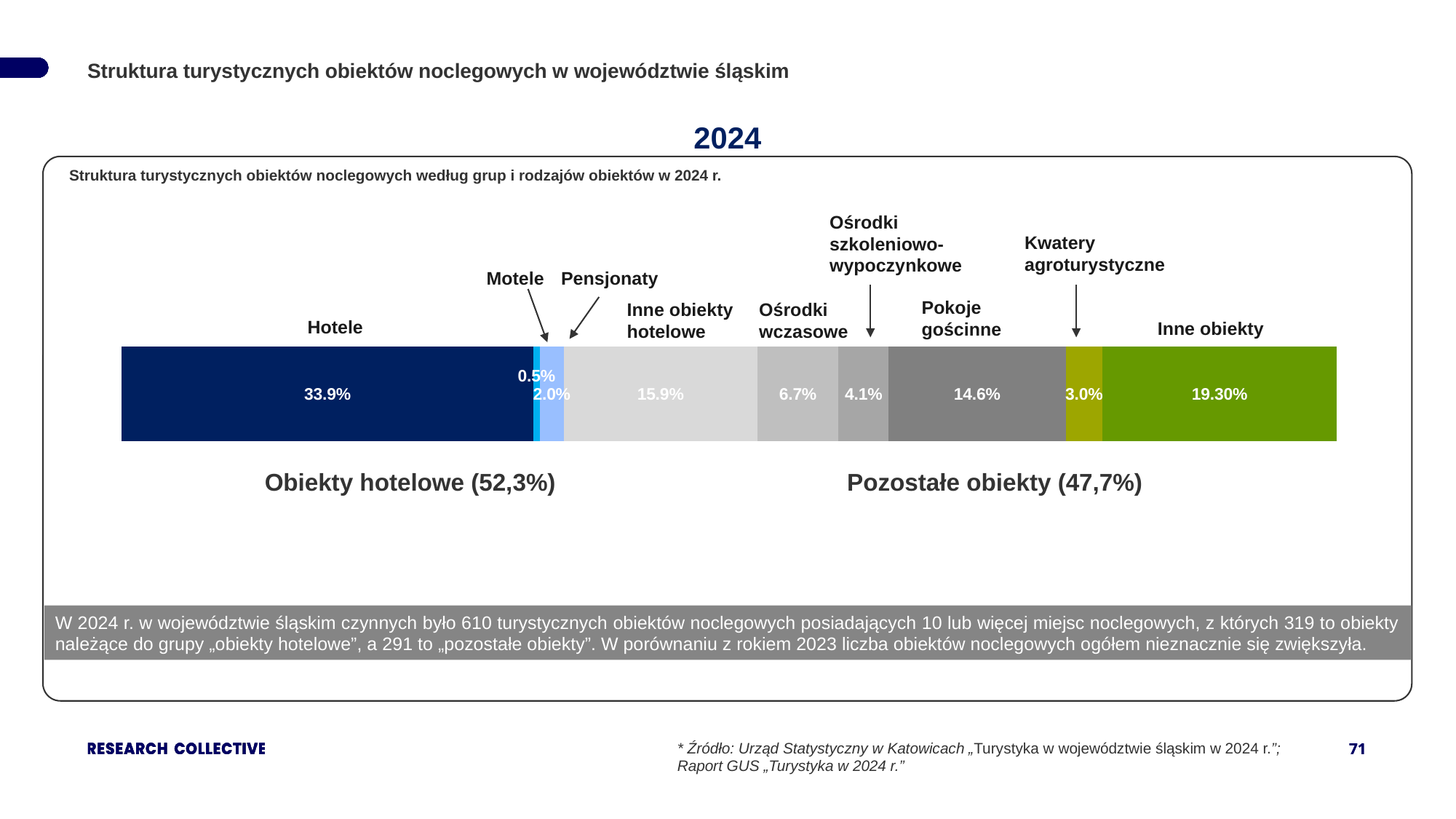
What value is shown for Pokoje gościnne? 14.6% Which has a larger share, Ośrodki wczasowe or Ośrodki szkoleniowo-wypoczynkowe? Ośrodki wczasowe What is the difference between the shares of Hotele and Inne obiekty? 14.6 percentage points What value is shown for Inne obiekty hotelowe? 15.9% What value is shown for Inne obiekty? 19.30% What share is given for the group Obiekty hotelowe below the bar? 52,3% What share of tourist accommodation establishments is shown for Hotele? 33.9% Which category has the smallest share in the bar? Motele How many categories (segments) are shown in the bar? 9 Which category has the largest share in the bar? Hotele What kind of chart is shown on the slide? Stacked bar chart What value is shown for Kwatery agroturystyczne? 3.0%